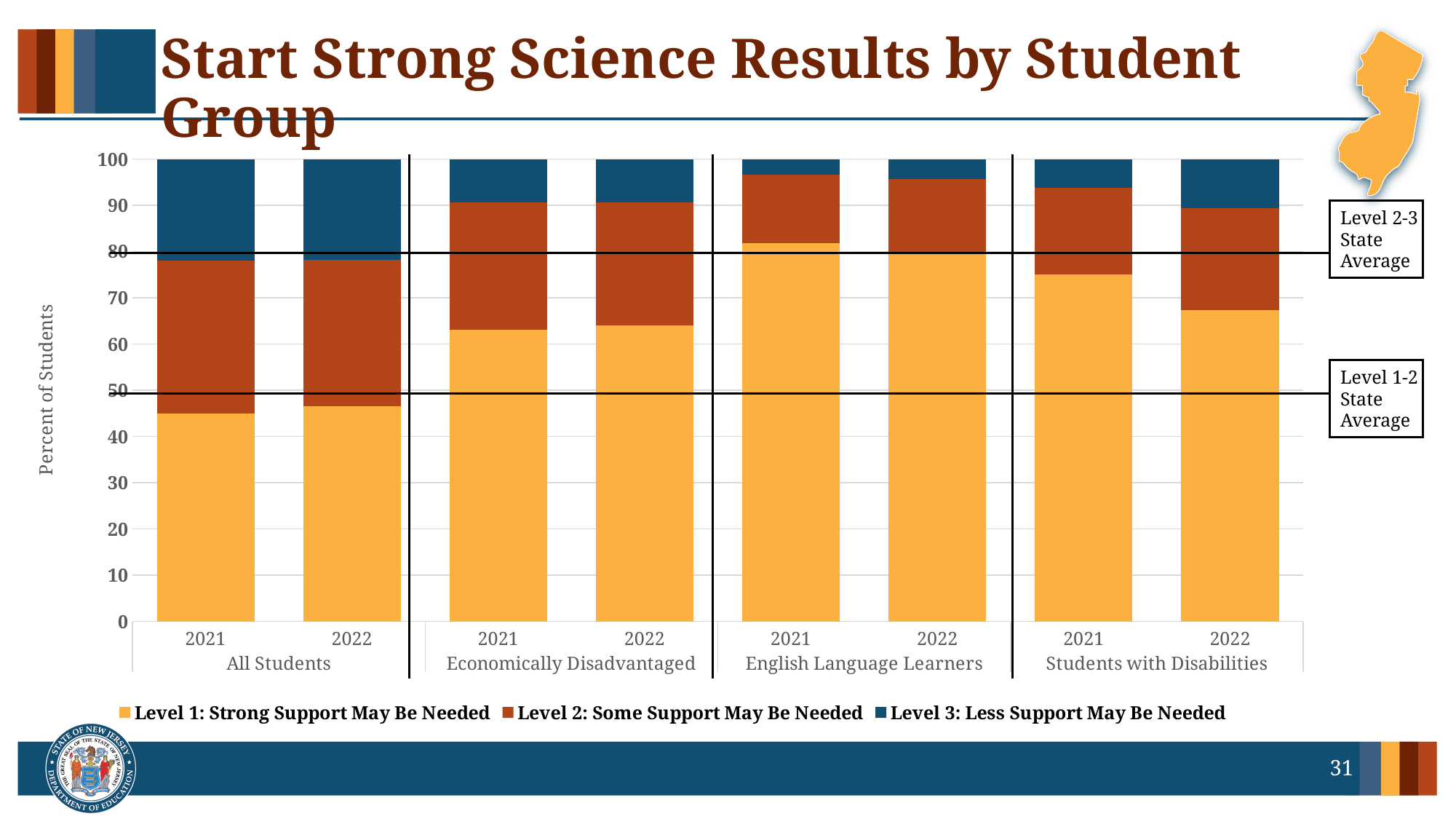
Is the Level 1 value for All Students in 2021 greater or less than 50? less How many series does the legend list? 3 What is the title of the y axis? Percent of Students How many student groups are shown along the x axis? 4 What kind of chart is shown on the slide? Stacked bar chart How many stacked bars are plotted in the chart? 8 Which student group has the largest Level 1 share in 2022? English Language Learners Which student group has the smallest Level 1 share in 2021? All Students Is the Level 1 value for English Language Learners in 2021 greater or less than 80? greater What is the total height of the stacked bar for All Students in 2021? 100 Which is larger: the Level 3 share for All Students in 2021 or for English Language Learners in 2021? All Students in 2021 Is the Level 1 value for Students with Disabilities in 2022 greater or less than 60? greater